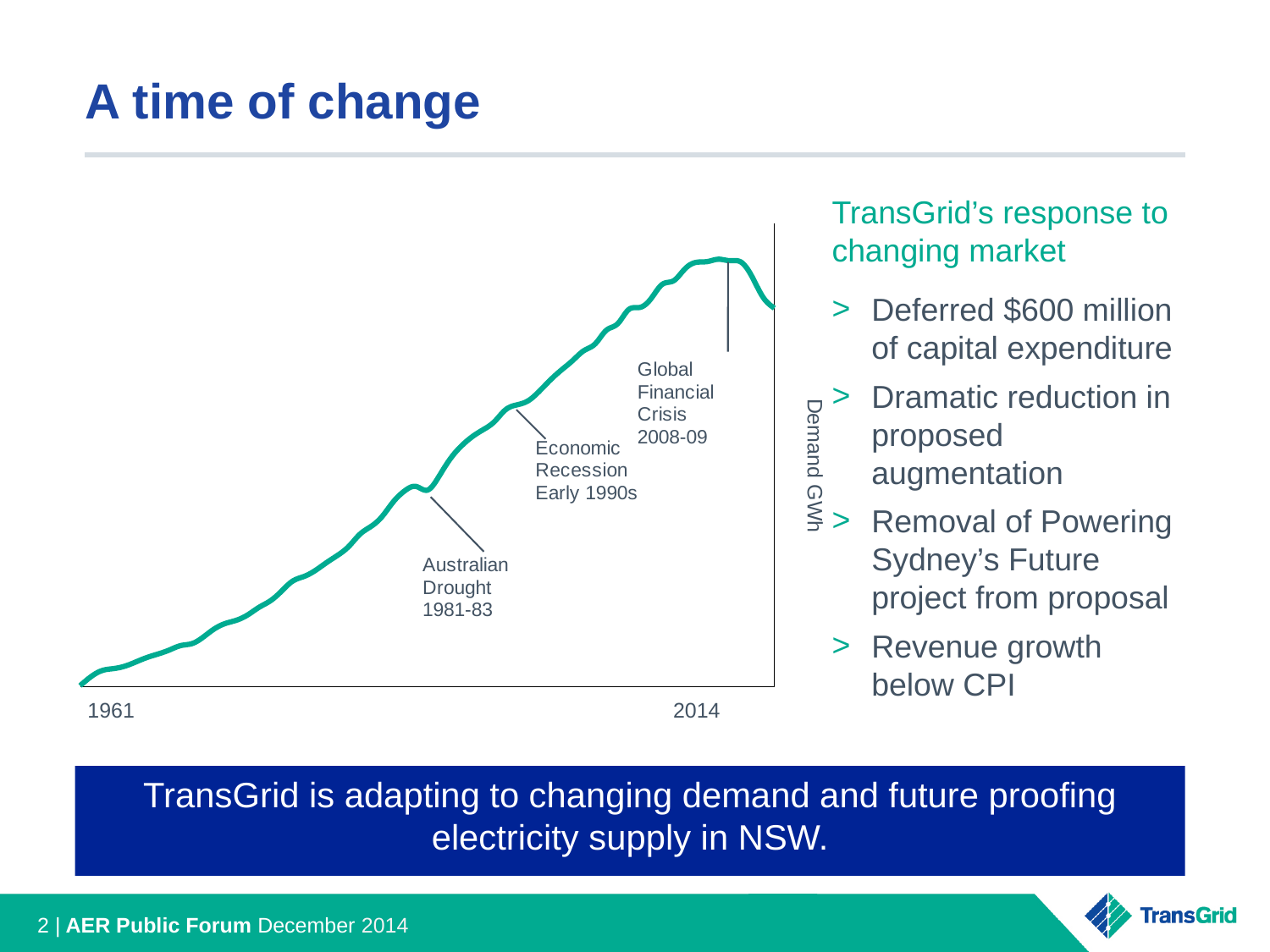
How many historical events are annotated on the chart? 3 Is demand at the Global Financial Crisis 2008-09 higher or lower than at the Australian Drought 1981-83? higher Is demand in 2014 higher or lower than demand in 1961? higher Does demand generally rise or fall along the x axis from 1961 to the late 2000s? rise In which period does the chart annotate an Economic Recession? Early 1990s Which event is annotated on the chart for 2008-09? Global Financial Crisis What kind of chart is shown on the slide? line chart Which event is annotated on the chart for 1981-83? Australian Drought What is the last year shown on the x axis of the chart? 2014 What is the label on the vertical axis of the chart? Demand GWh Does the line rise or fall in the final years before 2014? fall What is the first year shown on the x axis of the chart? 1961